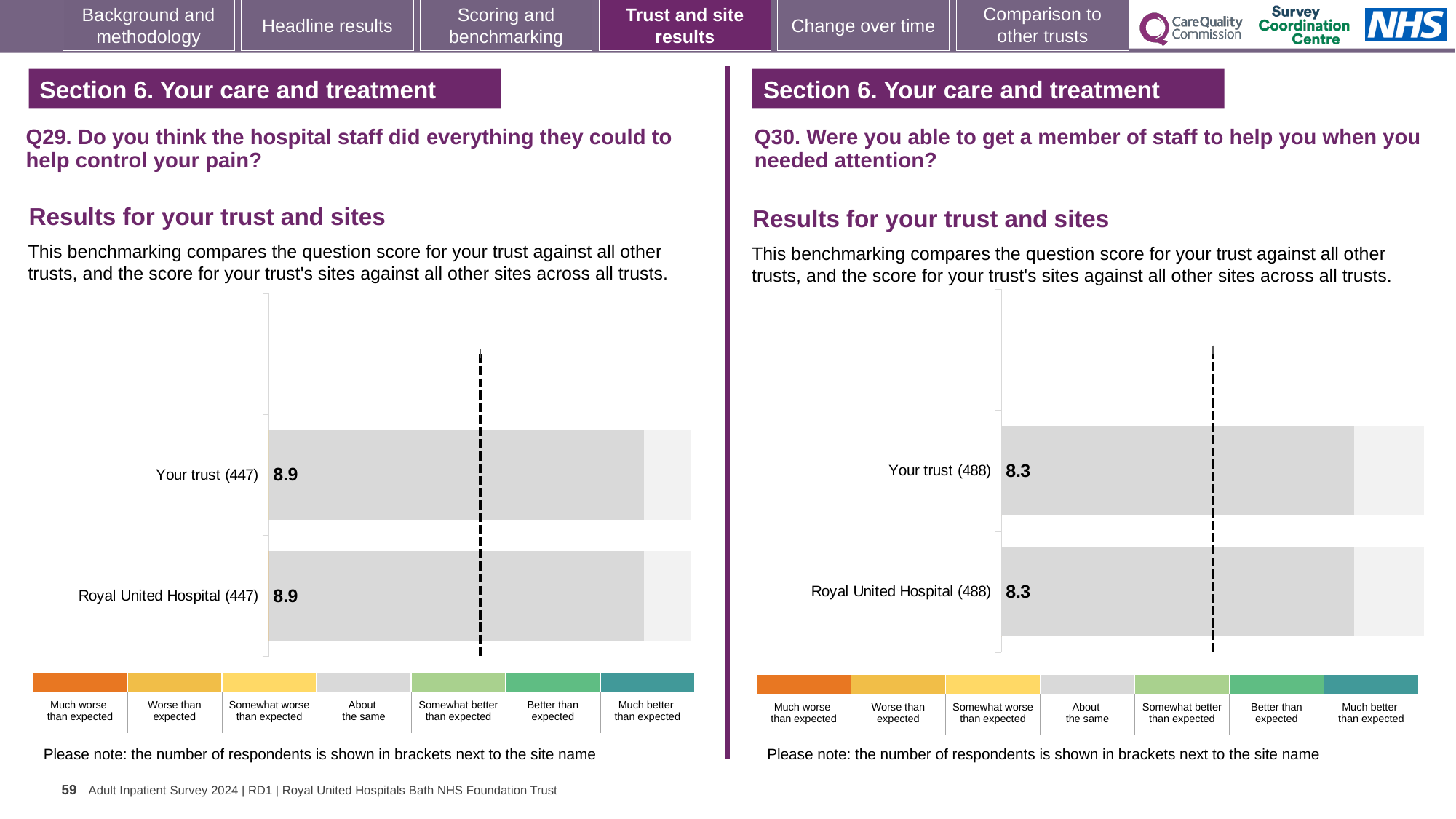
In the Q29 chart on the left, how many respondents are shown in brackets next to Your trust? 447 What kind of chart is the Q29 chart on the left? Bar chart In the Q29 chart on the left, what is the score for Royal United Hospital? 8.9 Is the score for Your trust in the Q29 chart on the left larger than, smaller than, or equal to the score for Your trust in the Q30 chart on the right? Larger How many bars are plotted in the Q30 chart on the right? 2 In the Q30 chart on the right, how many respondents are shown in brackets next to Royal United Hospital? 488 In the Q29 chart on the left, what is the difference between the score for Your trust and the score for Royal United Hospital? 0.0 How many bars are plotted in the Q29 chart on the left? 2 In the Q30 chart on the right, what is the score for Your trust? 8.3 In the Q30 chart on the right, what is the score for Royal United Hospital? 8.3 In the Q30 chart on the right, what is the difference between the score for Your trust and the score for Royal United Hospital? 0.0 In the Q29 chart on the left, what is the score for Your trust? 8.9